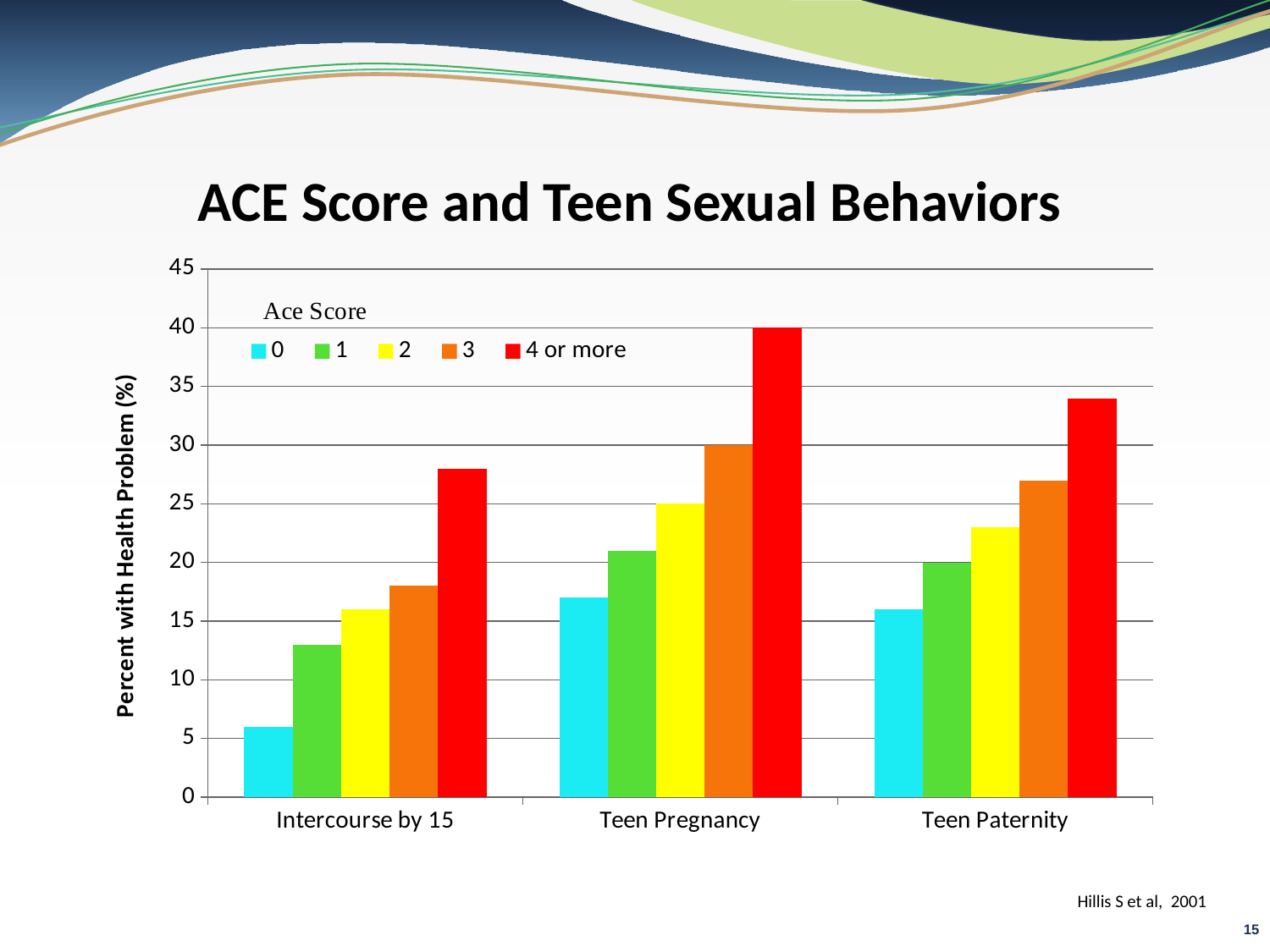
What is the value for ACE score 1 in the Teen Paternity category? 20 Is the value for ACE score 4 or more in the Teen Paternity category greater or less than 30? greater How many categories are shown on the x axis? 3 Which ACE score series has the lowest value in the Intercourse by 15 category? 0 What is the title of the chart's legend? Ace Score What kind of chart is shown on the slide? bar chart What is the value for ACE score 4 or more in the Teen Pregnancy category? 40 Within the Teen Paternity category, do the values rise or fall as the ACE score increases from 0 to 4 or more? rise What is the value for ACE score 3 in the Teen Pregnancy category? 30 Is the value for ACE score 0 in the Intercourse by 15 category greater or less than 10? less Which category has the highest value for ACE score 4 or more? Teen Pregnancy How many series does the legend list? 5